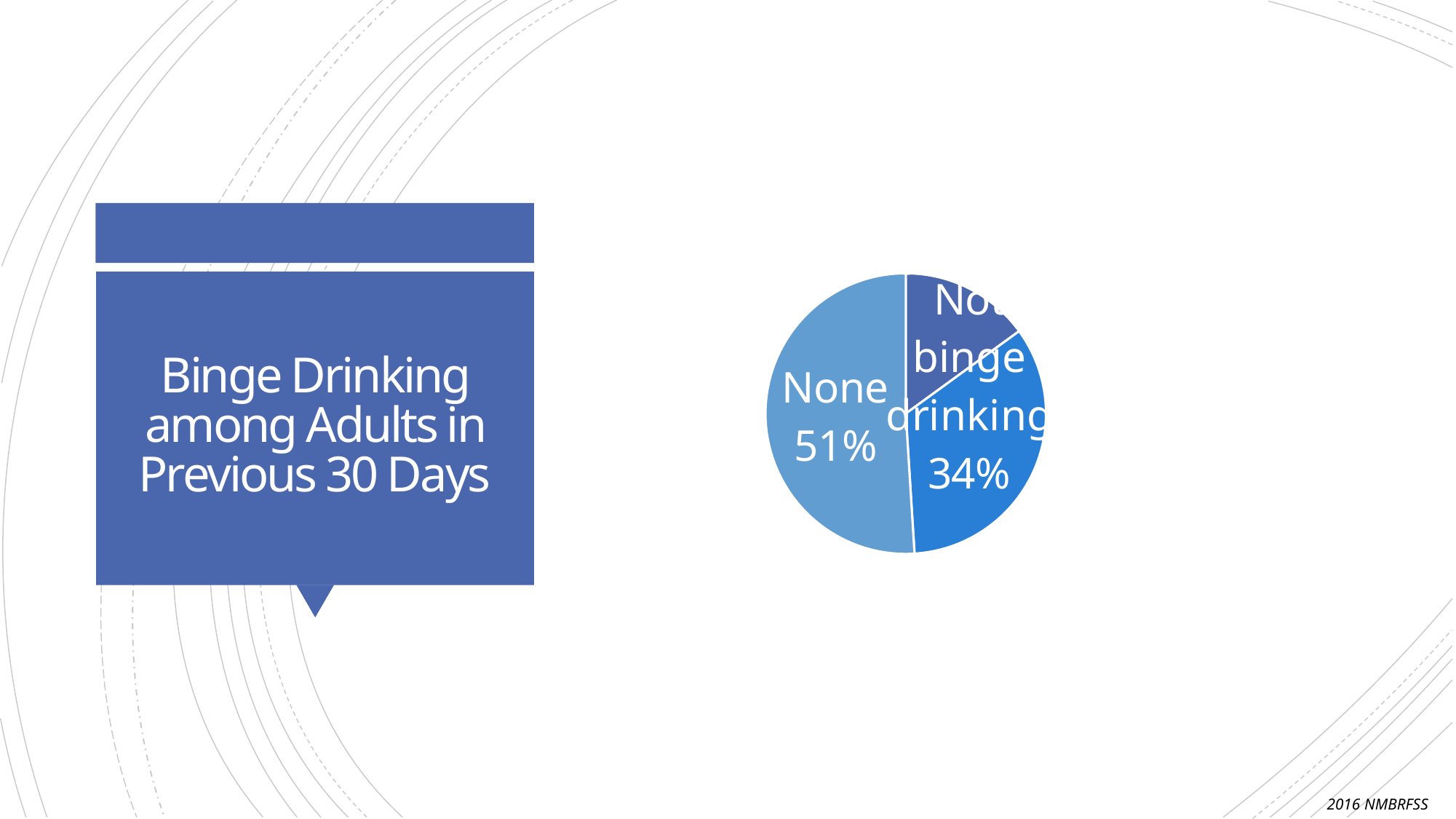
What share of the pie is labelled "None"? 51% What is the title shown in the text box next to the pie chart? Binge Drinking among Adults in Previous 30 Days What share of the pie is labelled "Not binge drinking"? 34% What kind of chart is shown on the slide? pie chart How many slices does the pie chart have? 3 What data source is cited at the bottom right of the slide? 2016 NMBRFSS Which labelled slice of the pie is the largest? None What is the difference in percentage points between the "None" slice (51%) and the "Not binge drinking" slice (34%)? 17 percentage points Which is larger, the "None" slice or the "Not binge drinking" slice? None Is the "None" slice greater or less than 50% of the pie? greater